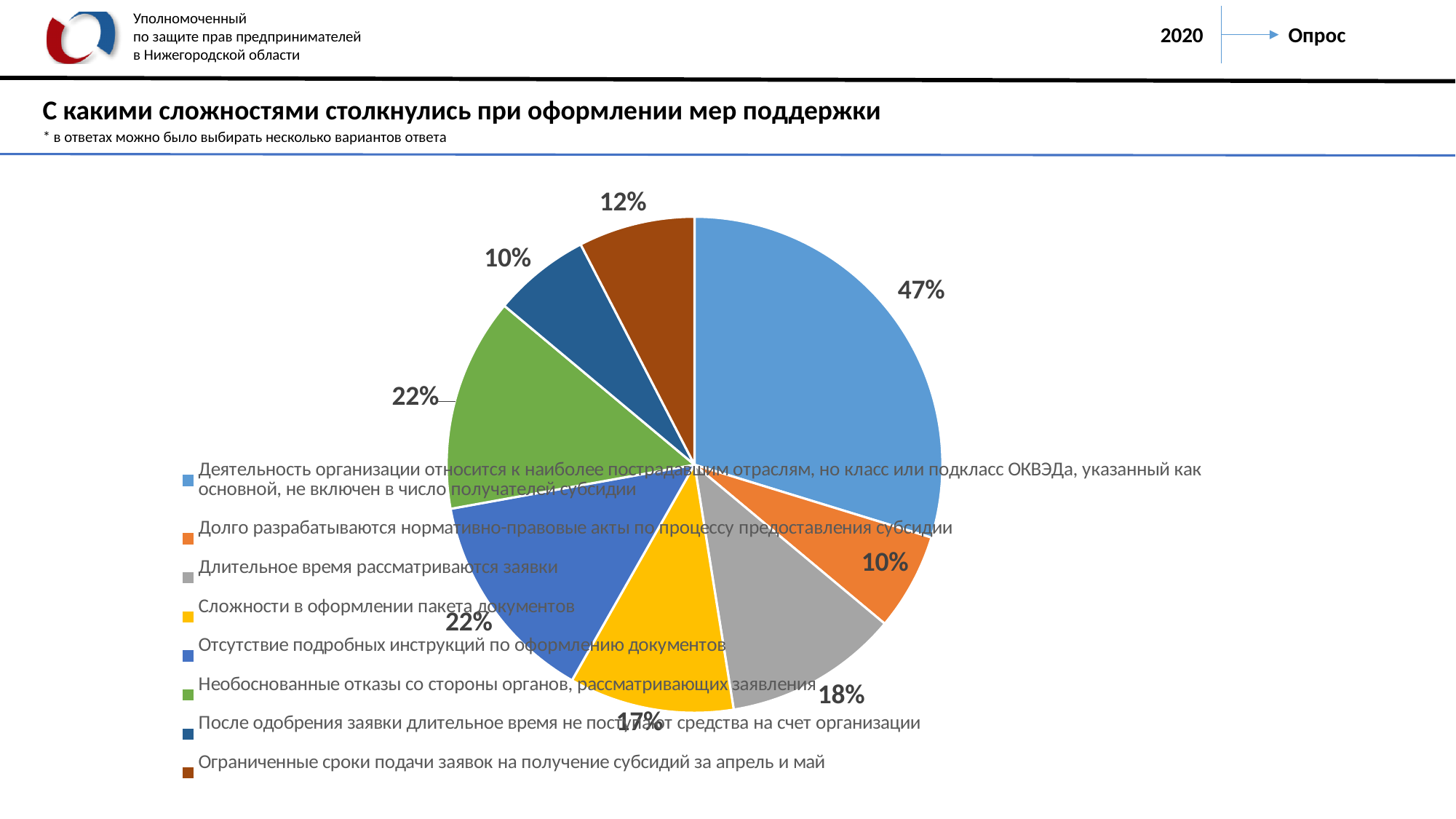
What percentage is shown for "Долго разрабатываются нормативно-правовые акты по процессу предоставления субсидии"? 10% What percentage is shown for "Длительное время рассматриваются заявки"? 18% How many categories (slices) does the pie chart have? 8 What colour is the slice for "Сложности в оформлении пакета документов"? Yellow What kind of chart is shown on the slide? Pie chart What is the title of the chart on the slide? С какими сложностями столкнулись при оформлении мер поддержки What is the share of the largest slice in the pie chart? 47% Which is larger: the share for "Отсутствие подробных инструкций по оформлению документов" or the share for "После одобрения заявки длительное время не поступают средства на счет организации"? Отсутствие подробных инструкций по оформлению документов Which category has the largest slice in the pie chart? Деятельность организации относится к наиболее пострадавшим отраслям, но класс или подкласс ОКВЭДа, указанный как основной, не включен в число получателей субсидии What percentage is shown for "Сложности в оформлении пакета документов"? 17% What is the difference in percentage points between the largest slice (47%) and "Необоснованные отказы со стороны органов, рассматривающих заявления" (22%)? 25 percentage points What percentage is shown for "Ограниченные сроки подачи заявок на получение субсидий за апрель и май"? 12%